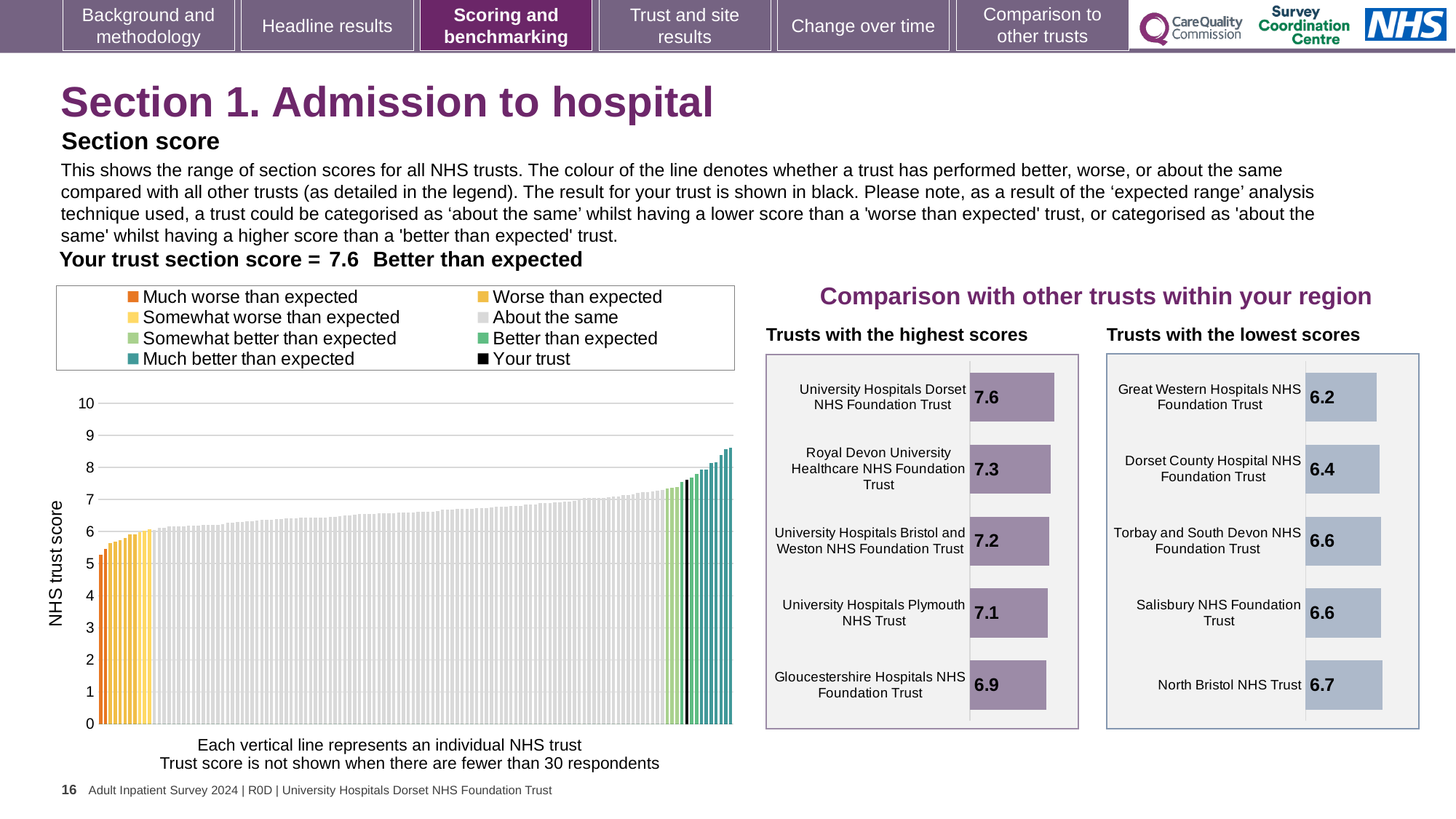
How many entries does the legend of the NHS trust score chart on the left list? 8 In the 'Trusts with the lowest scores' chart, which has the larger score: Torbay and South Devon NHS Foundation Trust or North Bristol NHS Trust? North Bristol NHS Trust In the 'Trusts with the lowest scores' chart, what is the score for Salisbury NHS Foundation Trust? 6.6 In the 'Trusts with the highest scores' chart, which trust has the highest score? University Hospitals Dorset NHS Foundation Trust How many trusts are shown in the 'Trusts with the highest scores' chart? 5 In the NHS trust score chart on the left, is the value of the black 'Your trust' bar greater or less than 7? greater What kind of chart is the NHS trust score chart on the left of the slide? Bar chart In the 'Trusts with the highest scores' chart, what is the difference between the scores of University Hospitals Dorset NHS Foundation Trust and Gloucestershire Hospitals NHS Foundation Trust? 0.7 In the 'Trusts with the lowest scores' chart, which trust has the lowest score? Great Western Hospitals NHS Foundation Trust In the 'Trusts with the highest scores' chart, what is the score for Royal Devon University Healthcare NHS Foundation Trust? 7.3 In the 'Trusts with the lowest scores' chart, what is the score for Dorset County Hospital NHS Foundation Trust? 6.4 In the NHS trust score chart on the left, do the values rise or fall from left to right? Rise